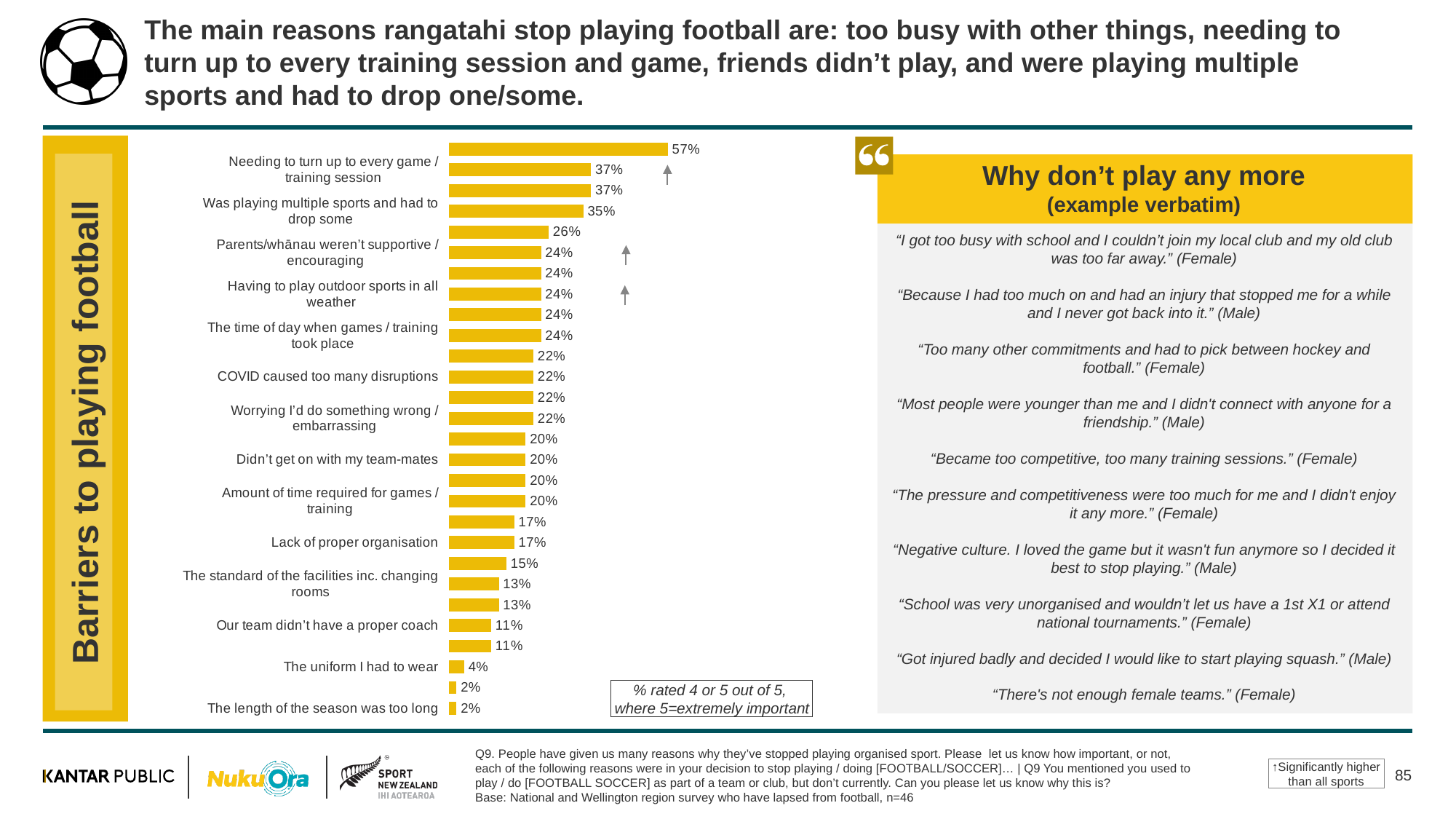
What is the highest percentage shown on the bar chart? 57% What percentage is shown for 'The uniform I had to wear'? 4% What percentage is shown for 'Was playing multiple sports and had to drop some'? 35% What percentage is shown for 'Our team didn't have a proper coach'? 11% How many bars are plotted in the barriers chart? 28 Which has a higher value: 'Parents/whānau weren't supportive / encouraging' or 'The standard of the facilities inc. changing rooms'? Parents/whānau weren't supportive / encouraging What is the difference in percentage points between 'Needing to turn up to every game / training session' and 'Lack of proper organisation'? 20 What type of chart is used to show the barriers to playing football? Bar chart According to the note box on the chart, what do the percentages represent? % rated 4 or 5 out of 5, where 5=extremely important What percentage is shown for 'COVID caused too many disruptions'? 22% What is the lowest percentage shown on the bar chart? 2% What percentage is shown for 'Needing to turn up to every game / training session'? 37%